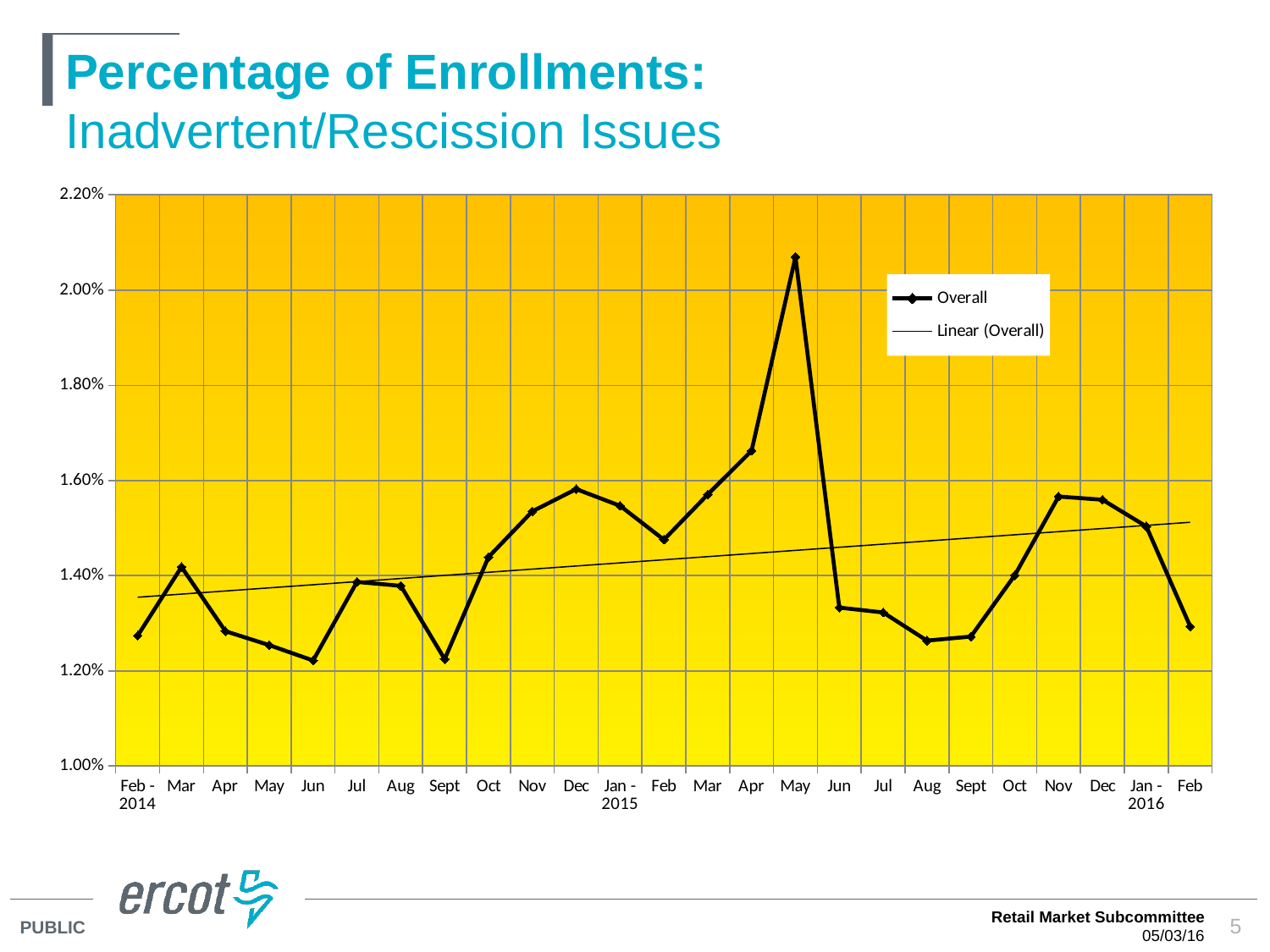
Is the Overall value for Aug 2015 greater or less than 1.40%? less What kind of chart is shown on the slide? Line chart Is the Overall value for Apr 2015 greater or less than 1.60%? greater What are the two entries listed in the chart legend? Overall and Linear (Overall) Does the Linear (Overall) trend line rise or fall from left to right across the chart? Rise How many monthly data points are plotted on the Overall line? 25 Which is larger, the Overall value for Dec 2014 or for Feb 2015? Dec 2014 Is the Overall value for May 2015 greater or less than 2.00%? greater Which month has the highest Overall percentage of enrollments? May 2015 Which is larger, the Overall value for May 2015 or for Jun 2015? May 2015 How many entries does the chart legend list? 2